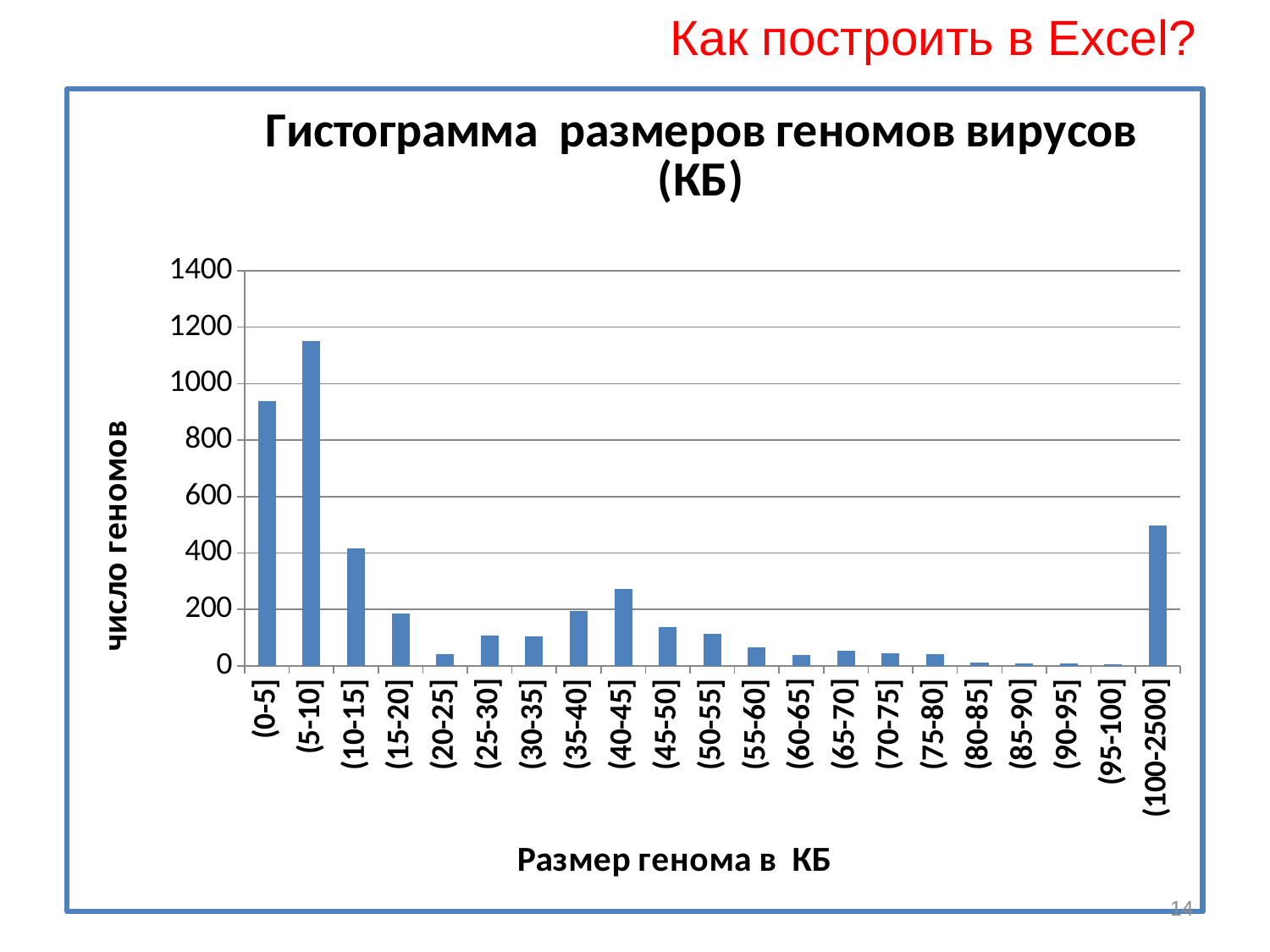
Do the values generally rise or fall from (40-45] to (95-100]? fall Is the value for (100-2500] greater or less than 400? greater Is the value for (0-5] greater or less than 800? greater Which has more genomes, (35-40] or (40-45]? (40-45] Is the value for (20-25] greater or less than 200? less What is the title of the chart? Гистограмма размеров геномов вирусов (КБ) What kind of chart is shown on the slide? bar chart How many genome size categories are shown on the x axis? 21 Which has more genomes, (0-5] or (5-10]? (5-10] Which genome size category has the highest number of genomes? (5-10] What is the label of the vertical axis? число геномов